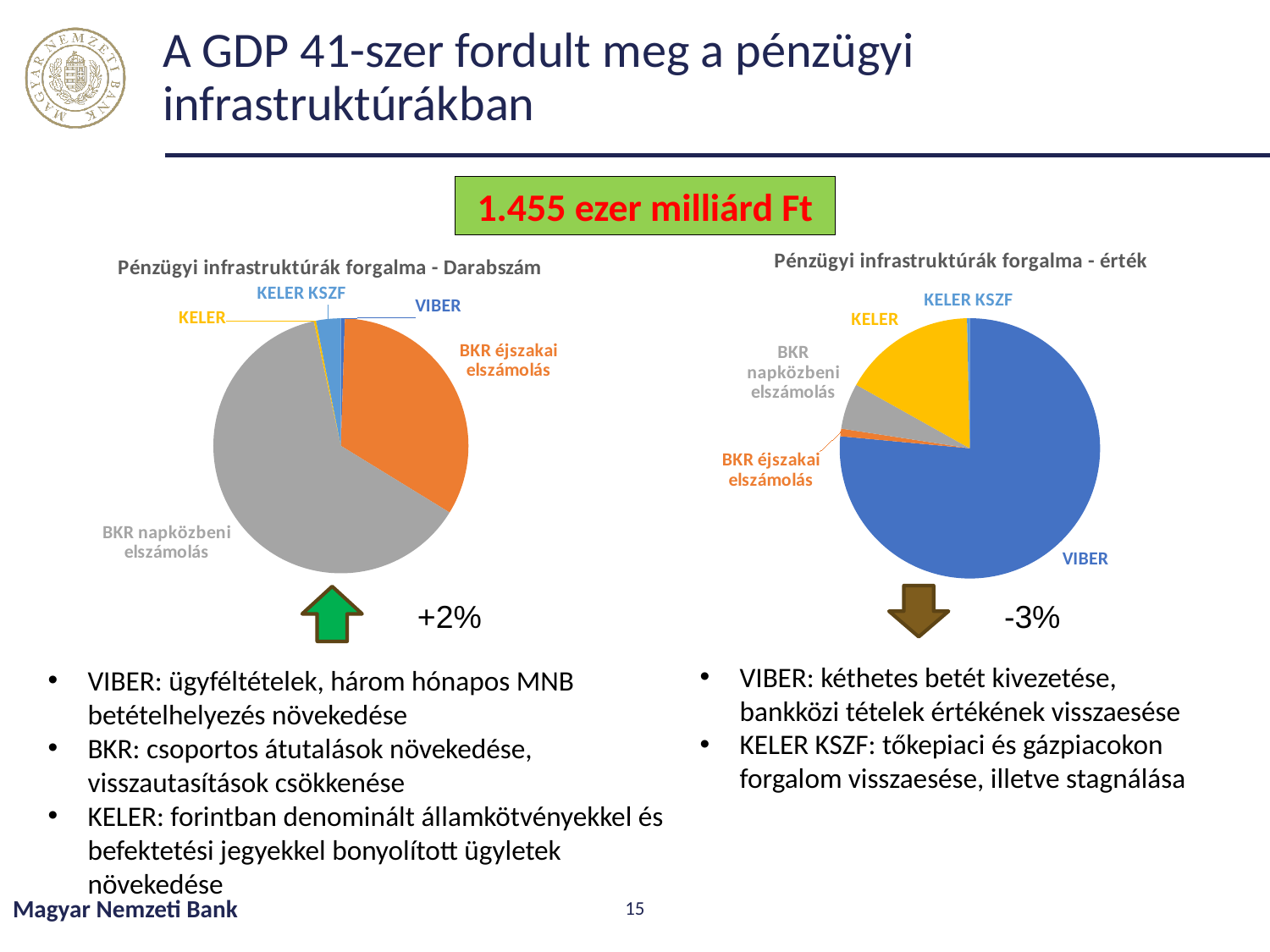
How many slices does the right chart, 'Pénzügyi infrastruktúrák forgalma - érték', have? 5 What kind of chart is the right chart, 'Pénzügyi infrastruktúrák forgalma - érték'? Pie chart In the left chart, 'Pénzügyi infrastruktúrák forgalma - Darabszám', which category has the largest slice? BKR napközbeni elszámolás In the right chart, 'Pénzügyi infrastruktúrák forgalma - érték', which slice is larger: KELER or BKR napközbeni elszámolás? KELER What kind of chart is the left chart, 'Pénzügyi infrastruktúrák forgalma - Darabszám'? Pie chart In the right chart, 'Pénzügyi infrastruktúrák forgalma - érték', which category has the largest slice? VIBER What is the title of the left pie chart on the slide? Pénzügyi infrastruktúrák forgalma - Darabszám In the right chart, 'Pénzügyi infrastruktúrák forgalma - érték', which slice is larger: VIBER or KELER? VIBER How many slices does the left chart, 'Pénzügyi infrastruktúrák forgalma - Darabszám', have? 5 In the left chart, 'Pénzügyi infrastruktúrák forgalma - Darabszám', which slice is larger: BKR éjszakai elszámolás or KELER KSZF? BKR éjszakai elszámolás What percentage change is shown below the right chart, 'Pénzügyi infrastruktúrák forgalma - érték'? -3%